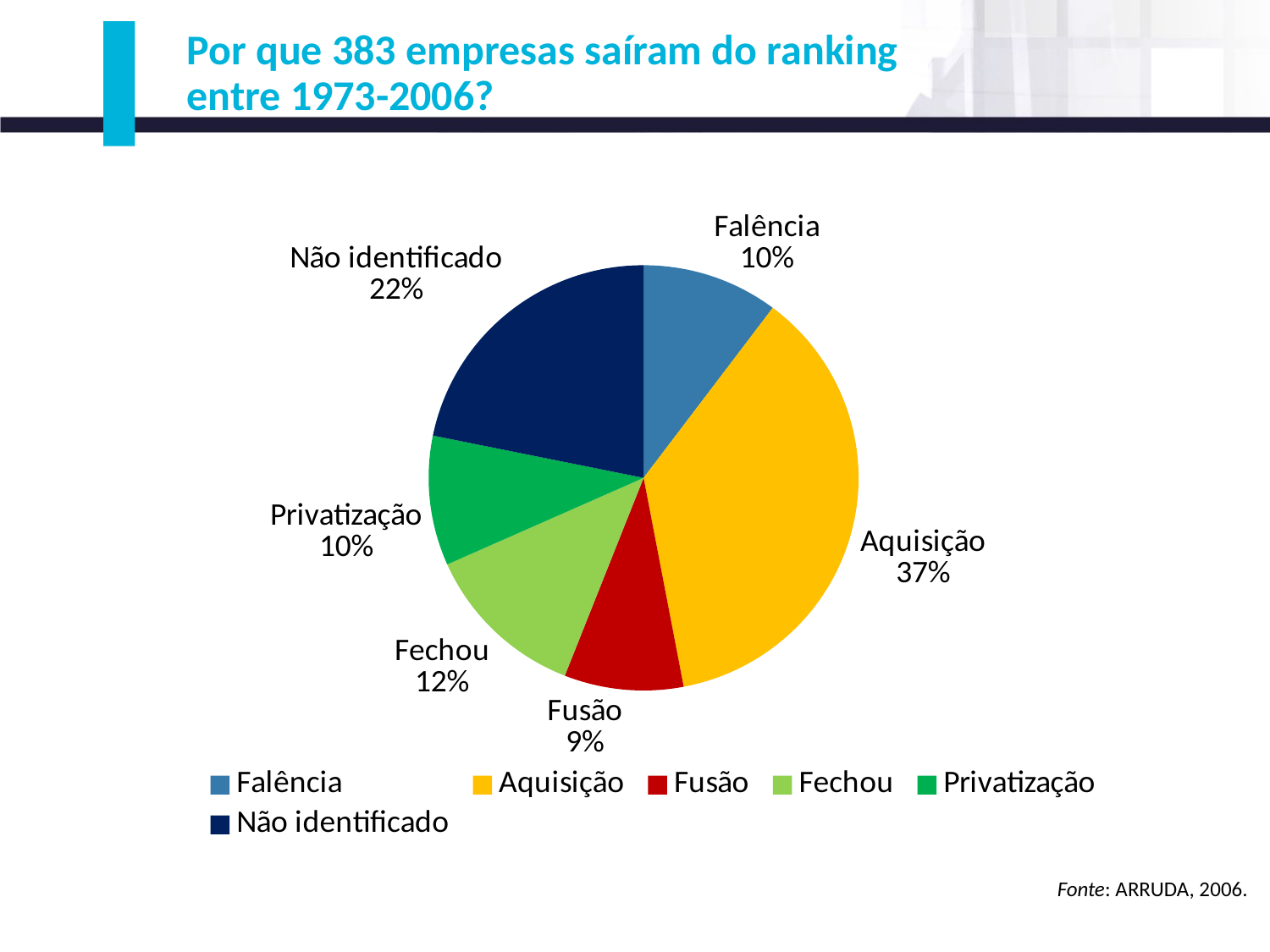
What is the value shown for Não identificado? 22% How many entries does the legend list? 6 Which category has the largest slice of the pie? Aquisição What is the difference in percentage points between Aquisição and Não identificado? 15 What colour is the Aquisição slice? yellow Which is larger, the slice for Fechou or the slice for Fusão? Fechou What is the value shown for Fechou? 12% How many categories are shown in the pie chart? 6 Which category has the smallest slice of the pie? Fusão What kind of chart is shown on the slide? pie chart What is the value shown for Fusão? 9% What share of the pie does Aquisição represent? 37%